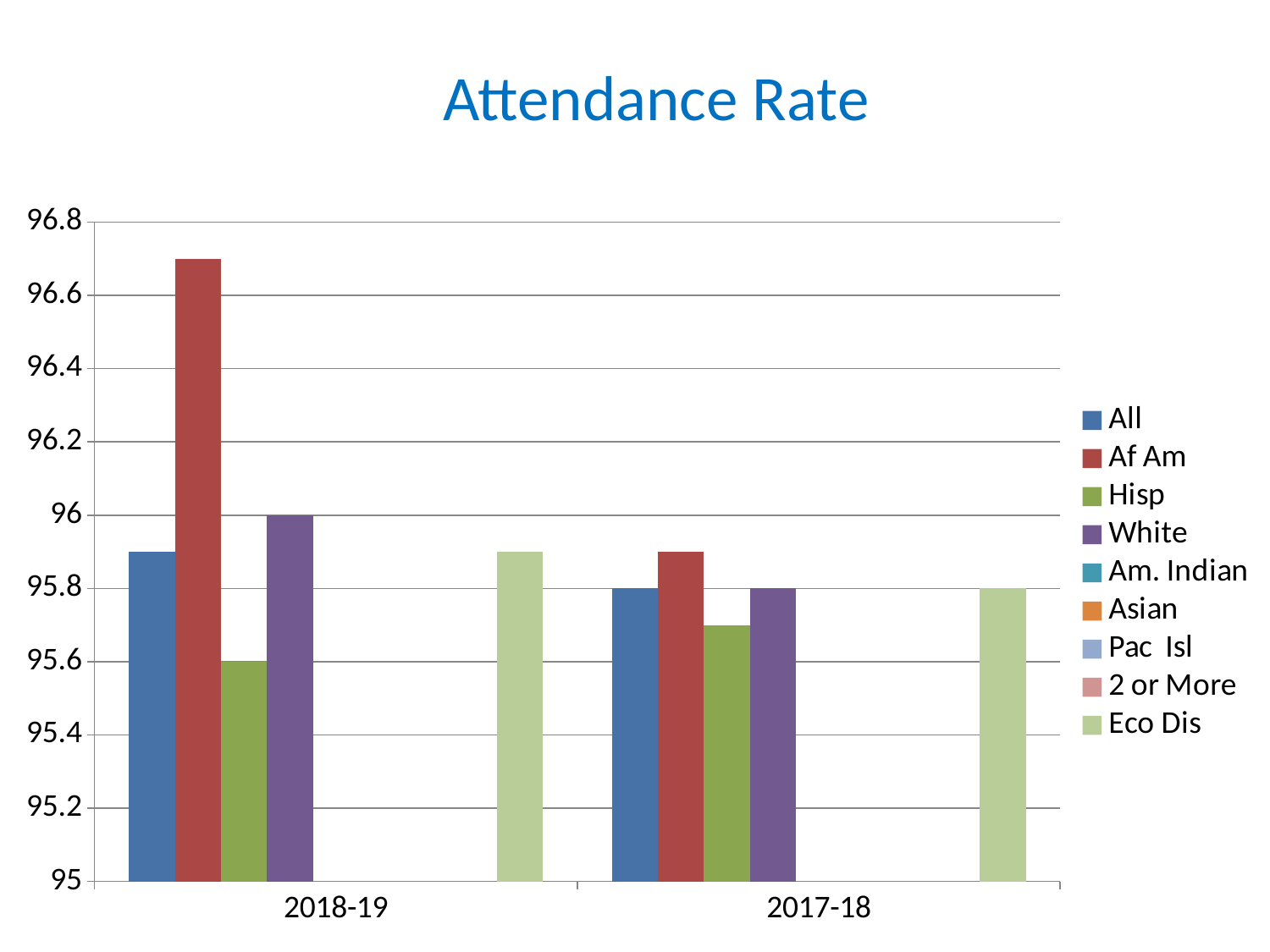
Which series has the highest value in 2018-19? Af Am Which series has the lowest value in 2017-18? Hisp How many categories are shown on the x axis? 2 How many series does the legend list? 9 What is the value for Hisp in 2018-19? 95.6 Is the value for Af Am in 2018-19 greater or less than 96.6? greater What is the value for White in 2018-19? 96 What is the value for All in 2017-18? 95.8 Does the Af Am value rise or fall from 2018-19 to 2017-18 along the x axis? fall What is the title of the chart? Attendance Rate What is the difference between the White and Hisp values in 2018-19? 0.4 What kind of chart is shown on the slide? bar chart